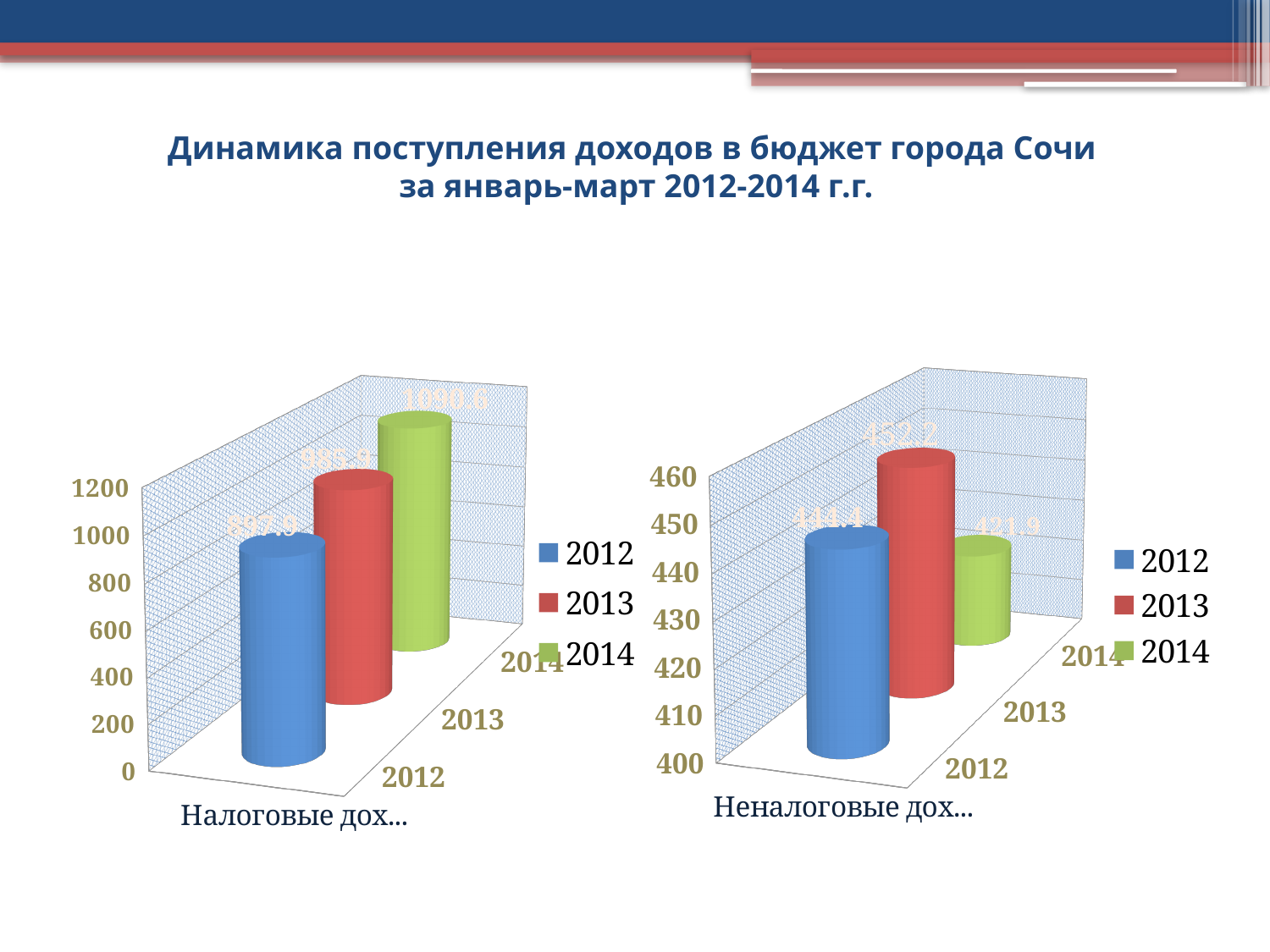
How many series does the legend of the left chart list? 3 In the right chart, what is the difference between the 2013 and 2012 values? 7.8 What kind of chart is the left chart? bar chart In the right chart, is the value for 2014 greater or less than 430? less In the left chart, which year has the highest value? 2014 In the left chart, what is the value for 2014? 1090.6 In the right chart, what is the value for 2013? 452.2 In the left chart, what is the value for 2012? 897.9 In the left chart, what is the difference between the 2014 and 2013 values? 104.7 In the left chart, do the values rise or fall from 2012 to 2014? rise In the right chart, which year has the lowest value? 2014 In the right chart, which is larger, the value for 2012 or the value for 2014? 2012